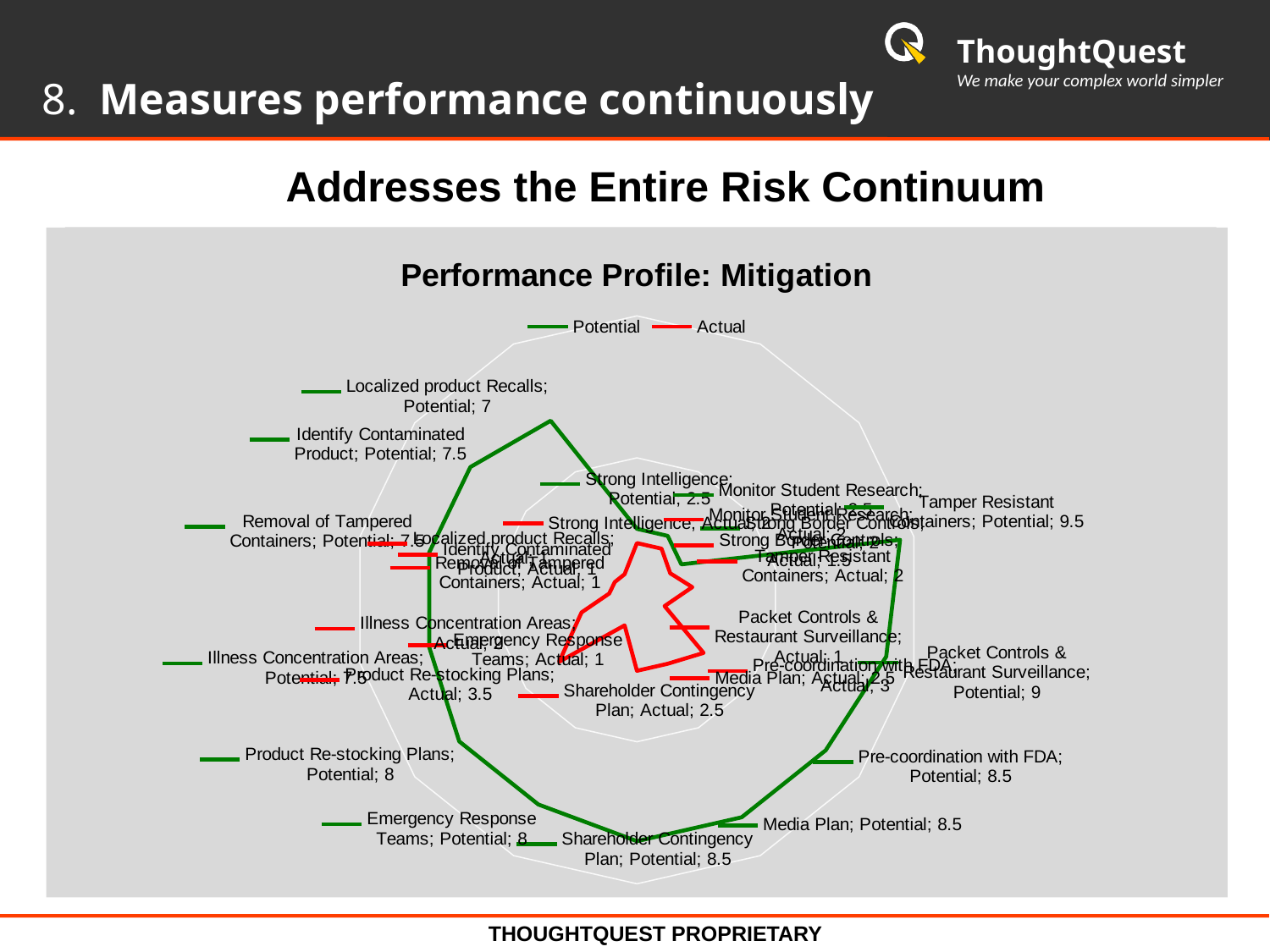
Which category has the highest Potential value? Tamper Resistant Containers What kind of chart is shown on the slide? Radar chart How many series does the chart's legend list? 2 What is the Potential value for Packet Controls & Restaurant Surveillance? 9 What is the difference between the Potential and Actual values for Media Plan? 6 What is the title of the chart? Performance Profile: Mitigation What is the difference between the Potential and Actual values for Packet Controls & Restaurant Surveillance? 8 What is the Potential value for Tamper Resistant Containers? 9.5 What is the Potential value for Localized product Recalls? 7 What is the Actual value for Product Re-stocking Plans? 3.5 What is the Actual value for Pre-coordination with FDA? 3 Which is larger: the Potential value for Pre-coordination with FDA or the Potential value for Product Re-stocking Plans? Pre-coordination with FDA